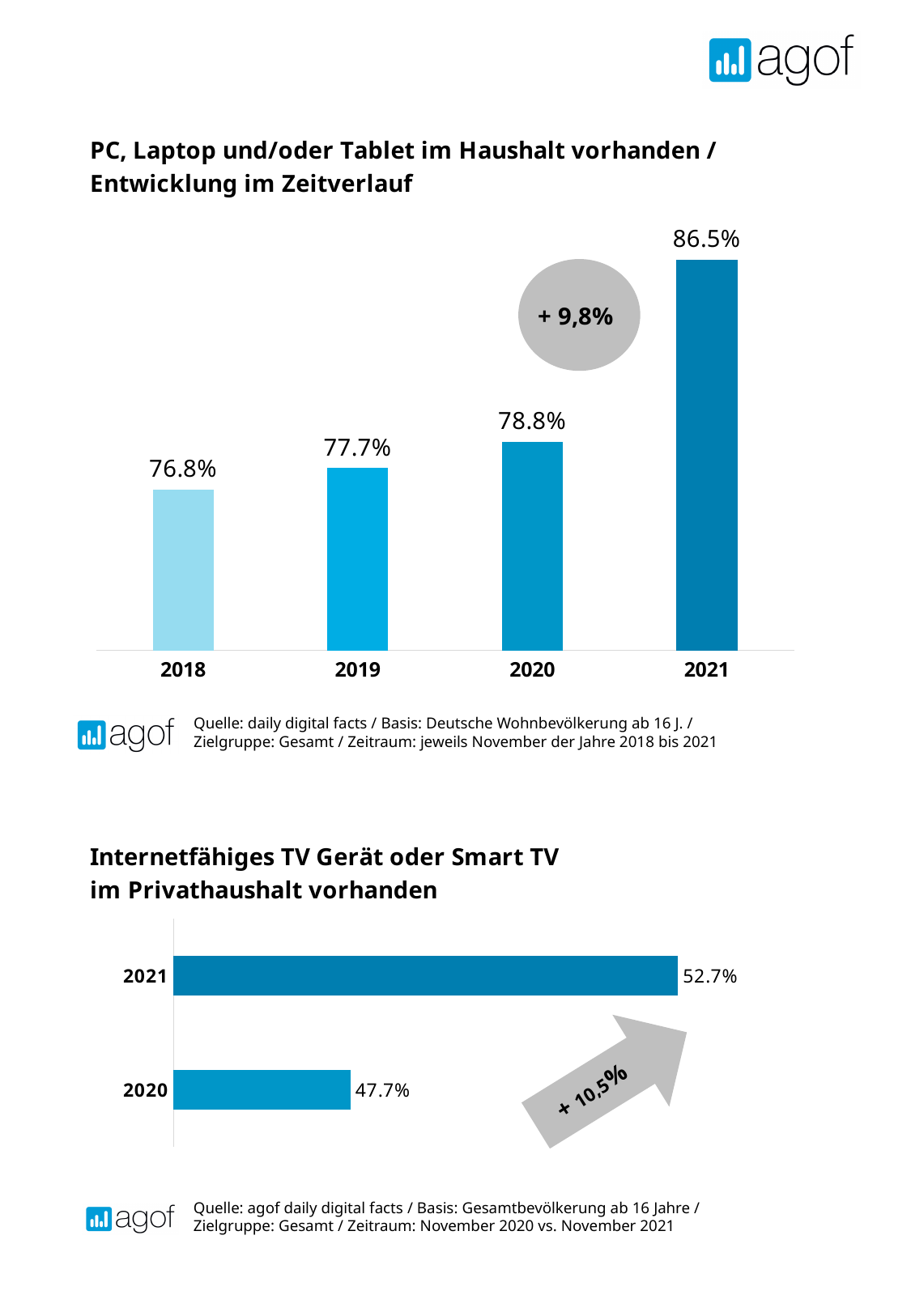
In the top chart (PC, Laptop und/oder Tablet im Haushalt vorhanden), which year has the lowest value? 2018 In the top chart (PC, Laptop und/oder Tablet im Haushalt vorhanden), how many years are shown? 4 In the top chart (PC, Laptop und/oder Tablet im Haushalt vorhanden), what is the value for 2018? 76.8% In the top chart (PC, Laptop und/oder Tablet im Haushalt vorhanden), what is the difference between the 2021 and 2020 values? 7.7 percentage points In the bottom chart (Internetfähiges TV Gerät oder Smart TV im Privathaushalt vorhanden), what is the value for 2020? 47.7% In the top chart (PC, Laptop und/oder Tablet im Haushalt vorhanden), do the values rise or fall from 2018 to 2021? rise What type of chart is the bottom chart (Internetfähiges TV Gerät oder Smart TV im Privathaushalt vorhanden)? bar chart In the top chart (PC, Laptop und/oder Tablet im Haushalt vorhanden), what is the value for 2021? 86.5% In the top chart (PC, Laptop und/oder Tablet im Haushalt vorhanden), which year has the highest value? 2021 In the bottom chart (Internetfähiges TV Gerät oder Smart TV im Privathaushalt vorhanden), what is the difference between the 2021 and 2020 values? 5.0 percentage points In the top chart (PC, Laptop und/oder Tablet im Haushalt vorhanden), what percentage change is shown in the grey circle? + 9,8% In the bottom chart (Internetfähiges TV Gerät oder Smart TV im Privathaushalt vorhanden), what is the value for 2021? 52.7%